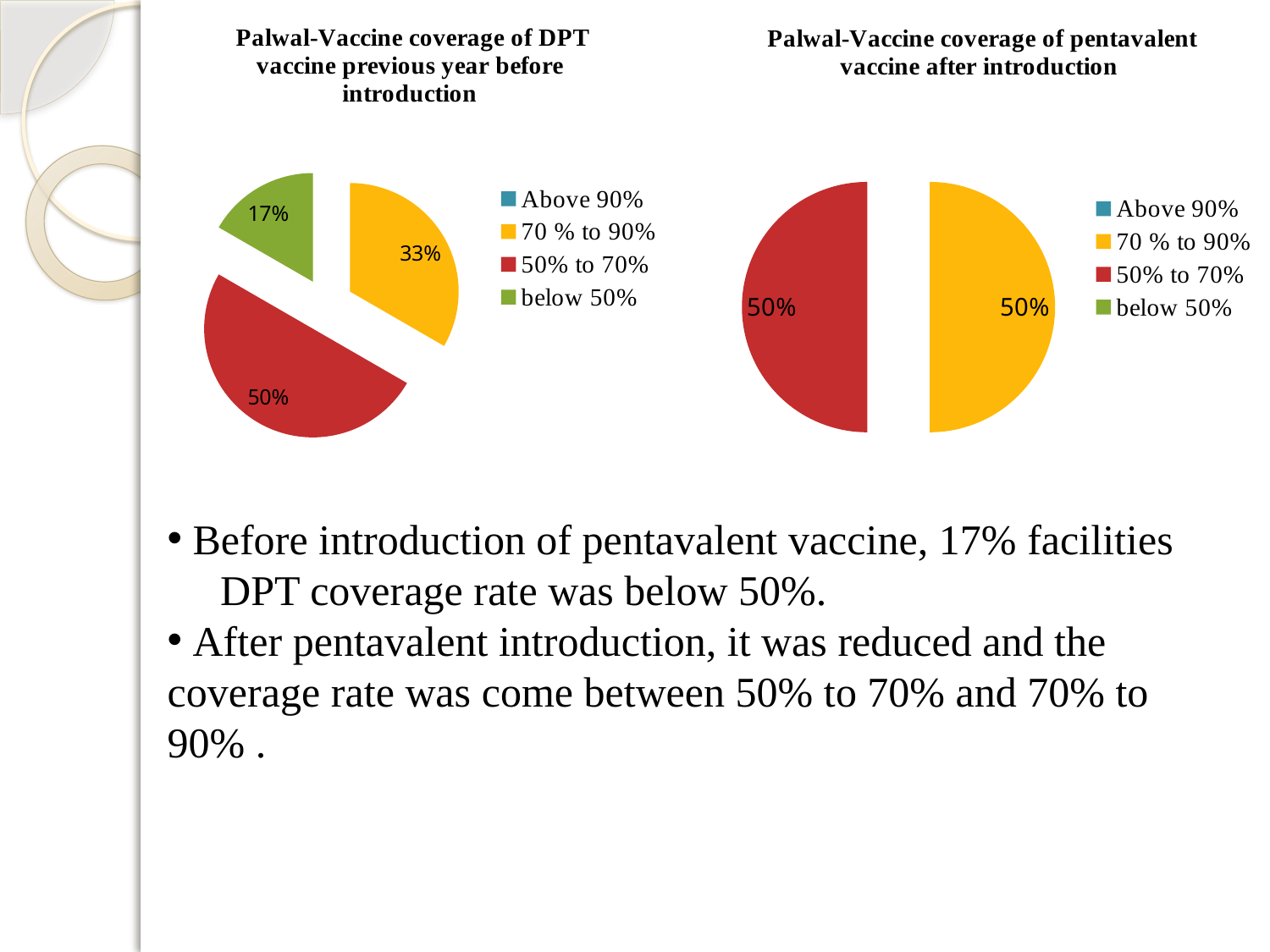
In the left chart (DPT vaccine before introduction), which visible slice is the smallest? below 50% In the left chart (DPT vaccine before introduction), what is the difference between the 50% to 70% slice and the below 50% slice? 33% What type of chart is used for the pentavalent vaccine coverage after introduction? Pie chart In the left chart (DPT vaccine before introduction), what share of facilities had coverage of 50% to 70%? 50% How many categories does the legend of the left chart list? 4 In the right chart (pentavalent vaccine after introduction), what share of facilities had coverage of 70% to 90%? 50% In the left chart (DPT vaccine before introduction), what share of facilities had coverage of 70% to 90%? 33% In the left chart (DPT vaccine before introduction), what share of facilities had coverage below 50%? 17% In the left chart (DPT vaccine before introduction), which is larger: the 70% to 90% slice or the below 50% slice? 70 % to 90% In the right chart (pentavalent vaccine after introduction), which colour represents the 50% to 70% category? Red In the left chart (DPT vaccine before introduction), which coverage category has the largest slice? 50% to 70% How many slices are visible in the right chart (pentavalent vaccine after introduction)? 2